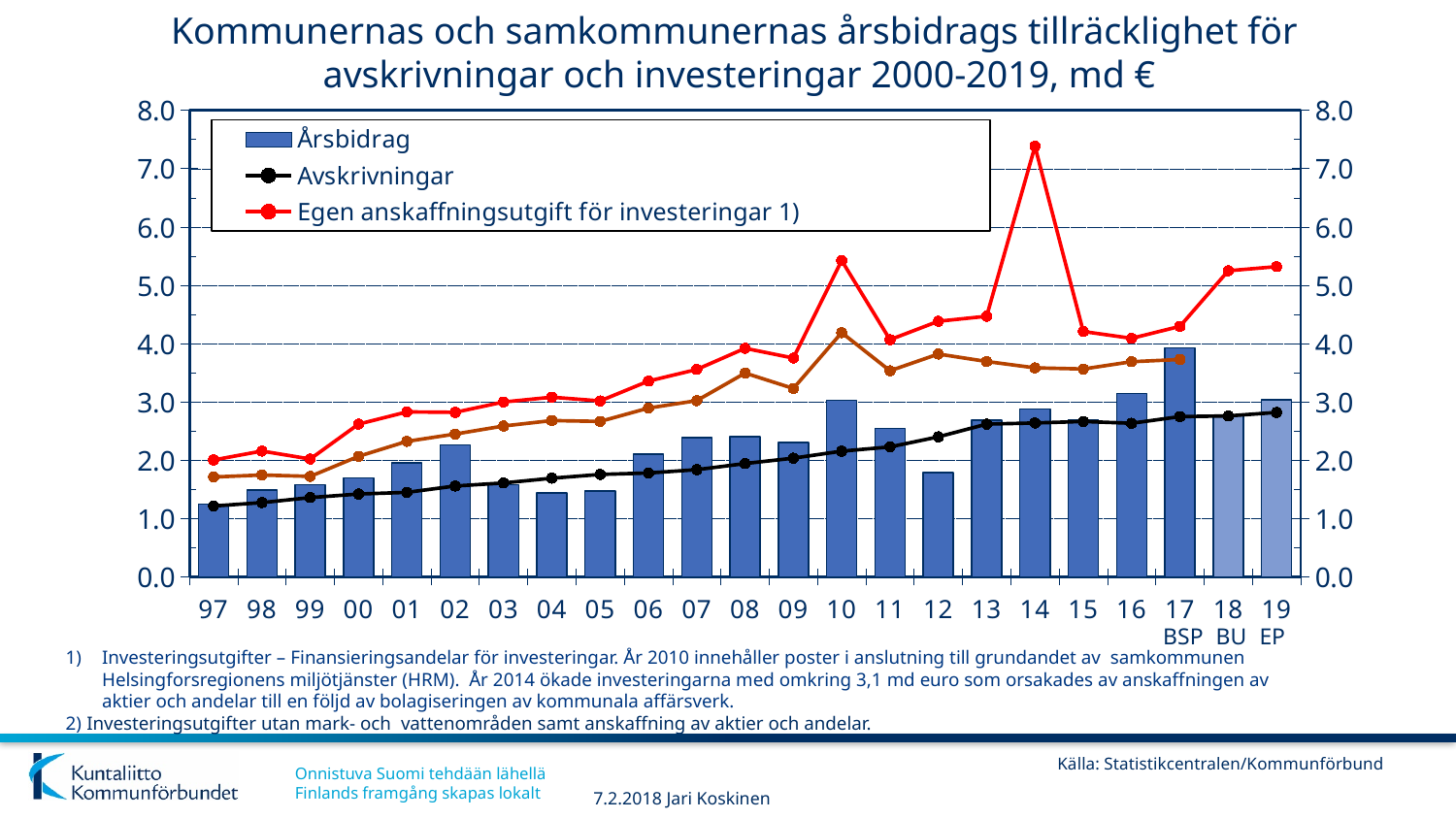
In which year is the Årsbidrag bar the tallest? 17 What kind of chart is shown on the slide? A combined bar and line chart How many series does the legend list? 3 Which is larger, the Årsbidrag bar for 2010 or for 2012? 2010 How many years (bars) are shown on the x axis? 23 Is the value of the red line (Egen anskaffningsutgift för investeringar) in 2014 greater or less than 7.0? greater In which year does the red line (Egen anskaffningsutgift för investeringar) reach its highest value? 14 In which year is the Årsbidrag bar the lowest? 97 Does the Avskrivningar line generally rise or fall from 1997 to 2019? rise Is the Årsbidrag bar for 2017 greater or less than 3.0? greater What is the unit given in the chart title? md € Is the Årsbidrag bar for 2004 greater or less than 2.0? less